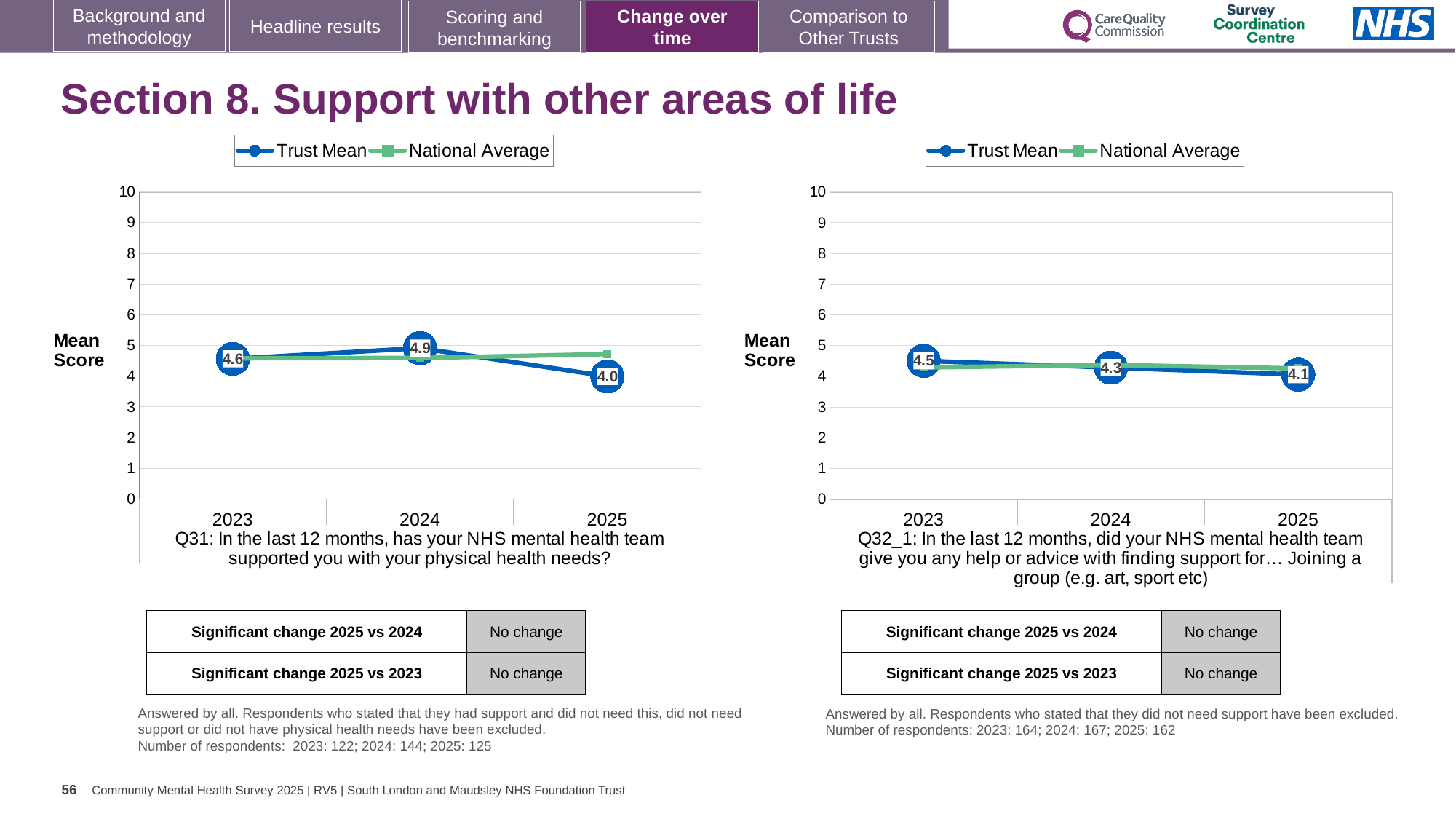
In the right chart (Q32_1), what is the Trust Mean for 2025? 4.1 In the left chart (Q31), is the Trust Mean for 2023 or 2025 larger? 2023 In the right chart (Q32_1), what is the difference between the Trust Mean for 2023 and 2025? 0.4 How many series does the legend of the left chart (Q31) list? 2 In the left chart (Q31), what is the difference between the Trust Mean for 2024 and 2025? 0.9 In the left chart (Q31), what is the Trust Mean for 2024? 4.9 In the left chart (Q31), what is the Trust Mean for 2025? 4.0 In the right chart (Q32_1), which year has the lowest Trust Mean? 2025 In the left chart (Q31), which year has the highest Trust Mean? 2024 In the right chart (Q32_1), what is the Trust Mean for 2023? 4.5 In the right chart (Q32_1), does the Trust Mean rise or fall from 2023 to 2025? fall What kind of chart is the right chart (Q32_1)? line chart